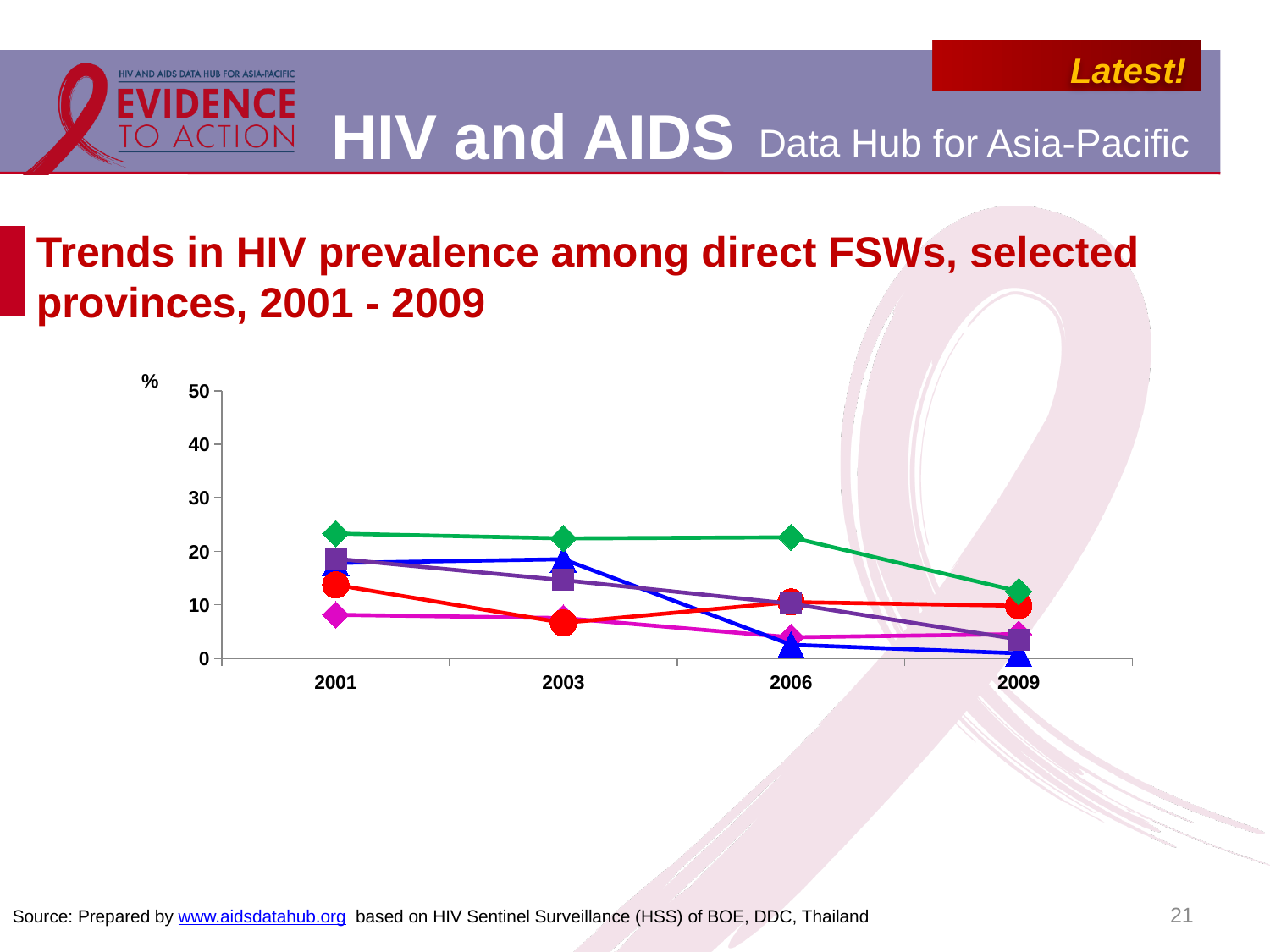
Is the value of the green line in 2001 greater or less than 20? greater What unit is shown on the y axis of the chart? % How many years are shown on the x axis of the chart? 4 Which line has the lowest value in 2009? the blue line Is the value of the red line in 2003 greater or less than 10? less What is the title of the chart on the slide? Trends in HIV prevalence among direct FSWs, selected provinces, 2001 - 2009 In 2009, which is larger: the value of the green line or the value of the purple line? the green line Does the green line rise or fall from 2001 to 2009? fall Is the value of the blue line in 2009 greater or less than 10? less What kind of chart is shown on the slide? line chart Which line has the highest value in 2001? the green line